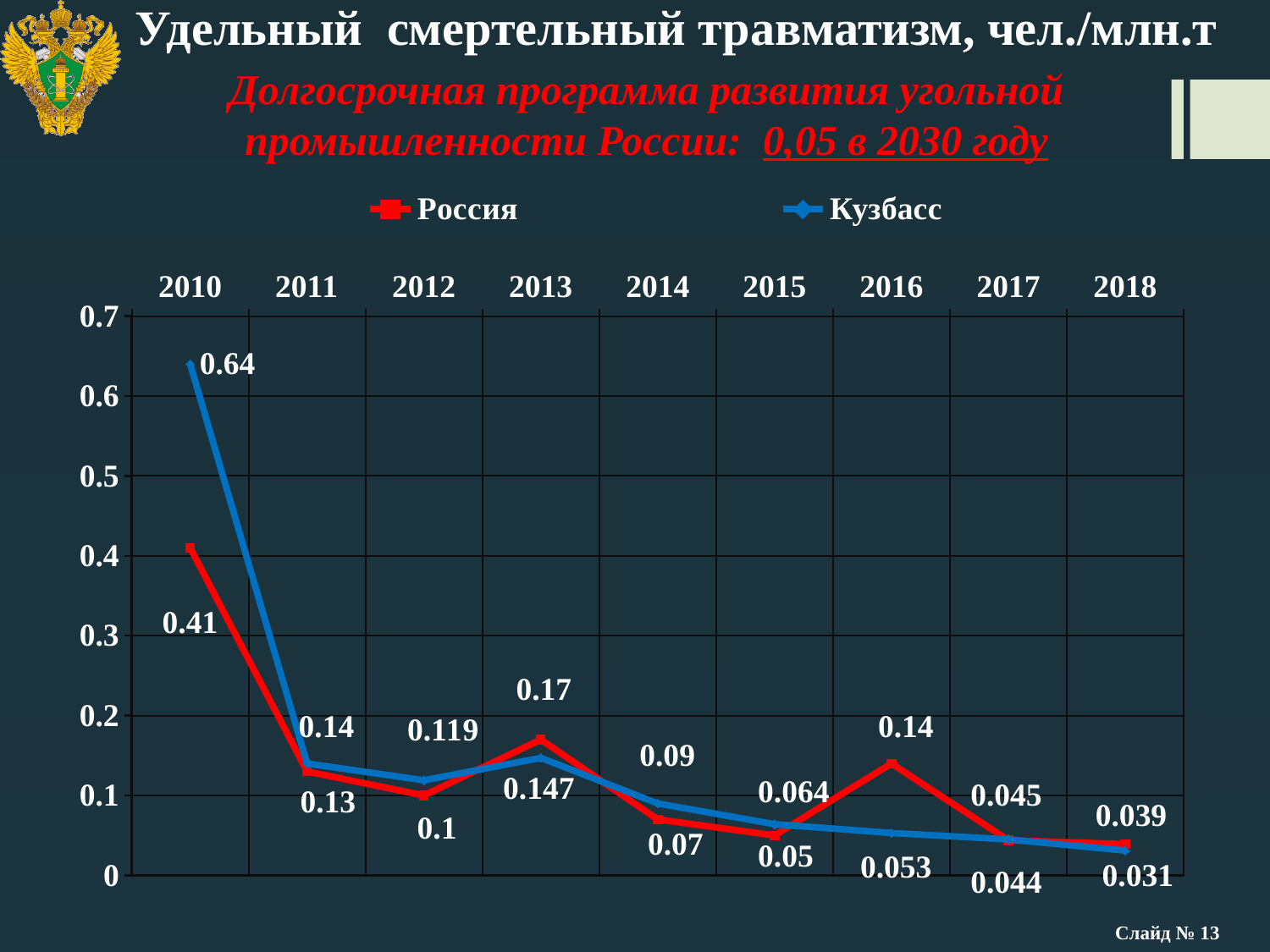
In which year is the Кузбасс value highest? 2010 What is the value for Кузбасс in 2010? 0.64 What is the difference between the Кузбасс and Россия values in 2010? 0.23 What is the value for Россия in 2016? 0.14 How many years are plotted along the x axis? 9 In 2014, which series has the higher value, Россия or Кузбасс? Кузбасс What is the value for Кузбасс in 2015? 0.064 What is the value for Россия in 2010? 0.41 What kind of chart is shown on the slide? line chart How many series does the legend list? 2 Does the Кузбасс series overall rise or fall from 2010 to 2018? fall What is the value for Россия in 2013? 0.17